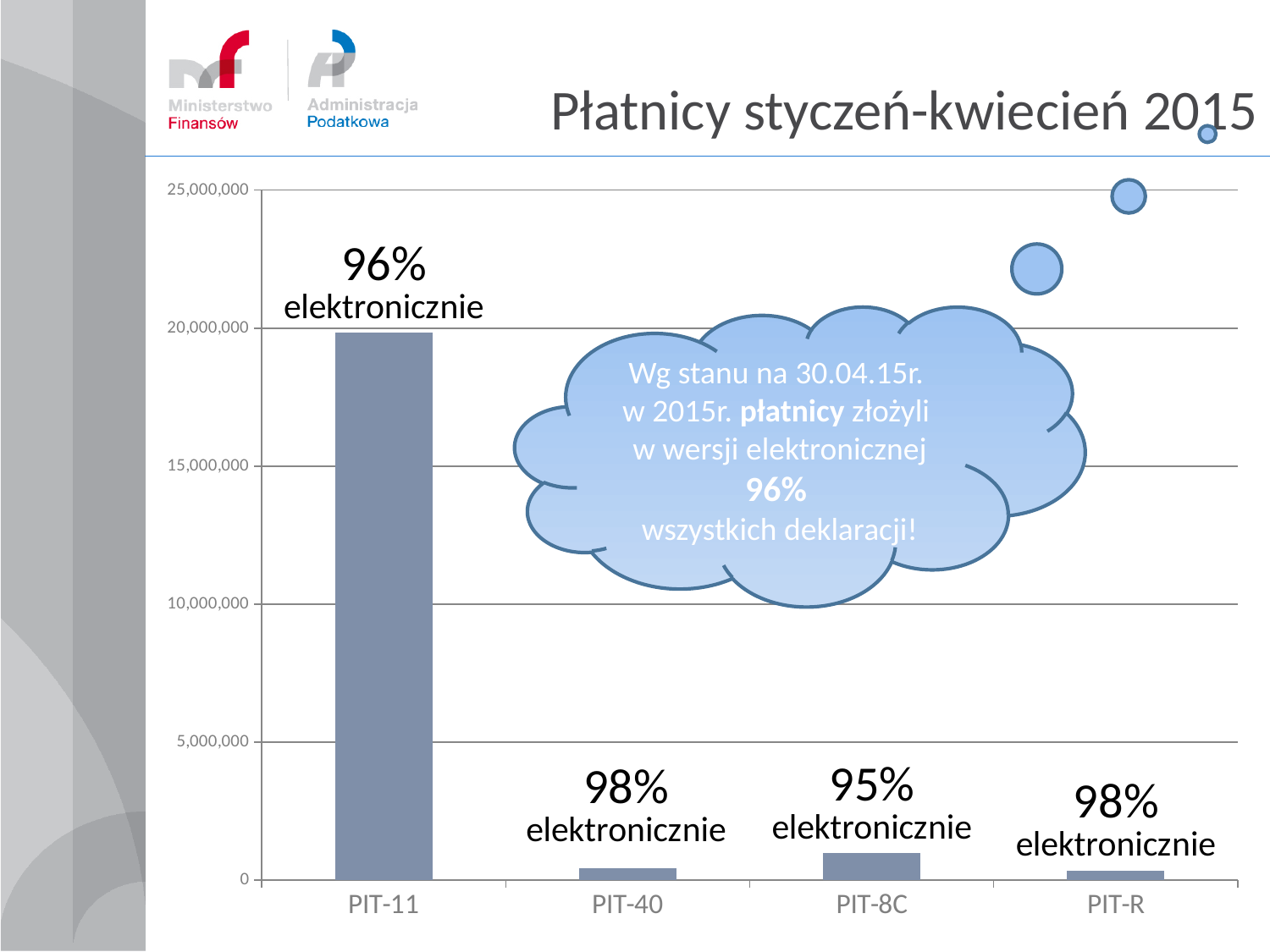
What is the title of the slide containing the chart? Płatnicy styczeń-kwiecień 2015 Which is larger, the value for PIT-11 or the value for PIT-8C? PIT-11 Which category has the highest bar in the chart? PIT-11 What percentage is labelled as filed electronically (elektronicznie) above the PIT-8C bar? 95% Which is larger, the value for PIT-8C or the value for PIT-40? PIT-8C Is the value for PIT-40 greater or less than 5,000,000? less What kind of chart is shown on the slide? bar chart Is the value for PIT-11 greater or less than 15,000,000? greater What percentage is labelled as filed electronically (elektronicznie) above the PIT-11 bar? 96% How many categories are shown on the x axis of the chart? 4 Is the value for PIT-8C greater or less than 5,000,000? less